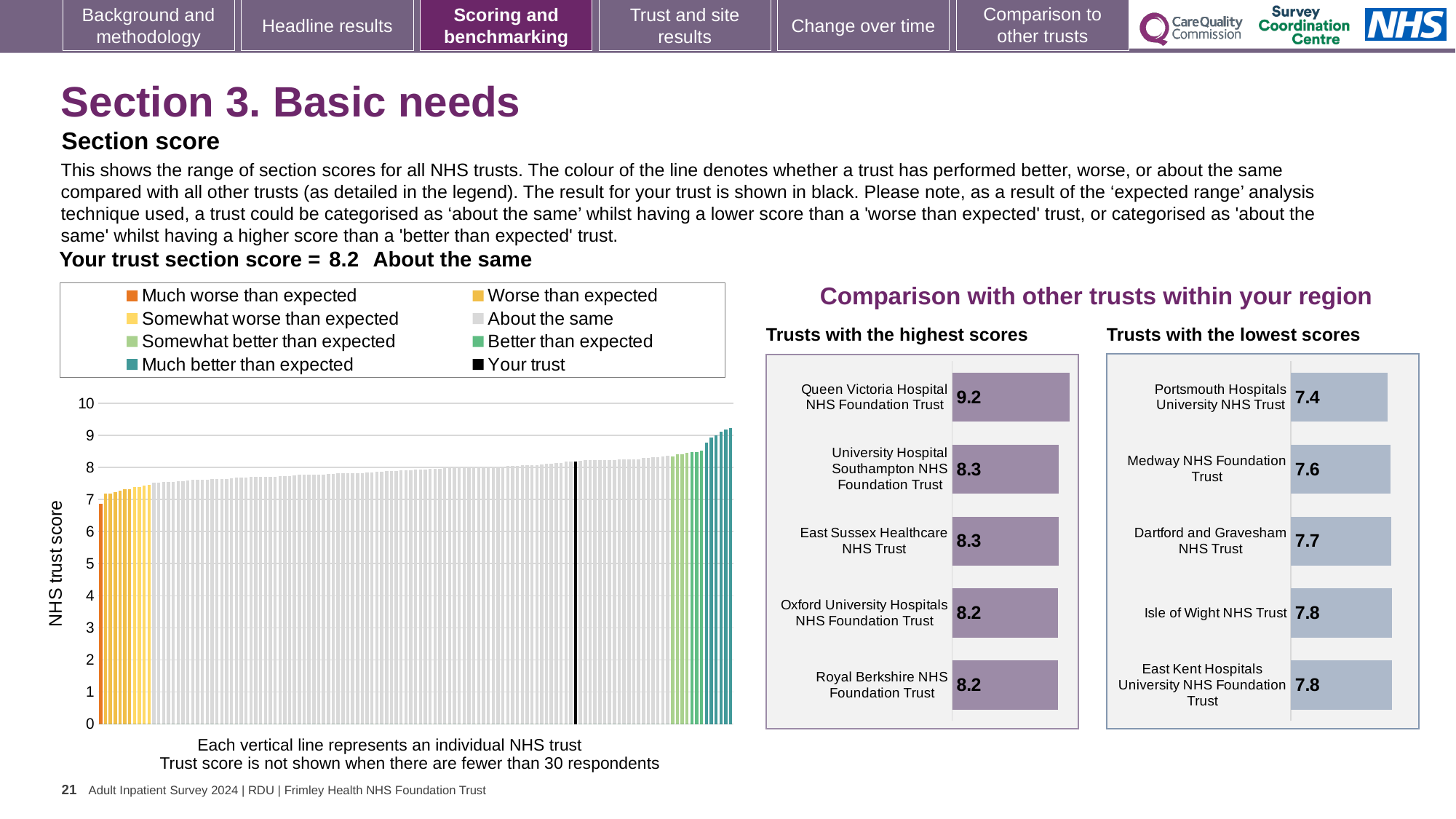
What kind of chart is the left-hand chart showing NHS trust scores? Bar chart On the left-hand chart of NHS trust scores, do the values rise or fall from left to right? Rise How many trusts are shown on the 'Trusts with the lowest scores' chart? 5 On the 'Trusts with the lowest scores' chart, what is the score for Medway NHS Foundation Trust? 7.6 On the 'Trusts with the lowest scores' chart, which trust has the lowest score? Portsmouth Hospitals University NHS Trust On the 'Trusts with the highest scores' chart, what is the score for Queen Victoria Hospital NHS Foundation Trust? 9.2 On the 'Trusts with the lowest scores' chart, what is the score for East Kent Hospitals University NHS Foundation Trust? 7.8 On the 'Trusts with the highest scores' chart, what is the difference between the scores of Queen Victoria Hospital NHS Foundation Trust and Royal Berkshire NHS Foundation Trust? 1.0 On the left-hand chart of NHS trust scores, what is the section score for your trust? 8.2 On the 'Trusts with the highest scores' chart, which trust has the highest score? Queen Victoria Hospital NHS Foundation Trust On the 'Trusts with the lowest scores' chart, which has the larger score: Dartford and Gravesham NHS Trust or Portsmouth Hospitals University NHS Trust? Dartford and Gravesham NHS Trust How many entries does the legend of the left-hand chart list? 8